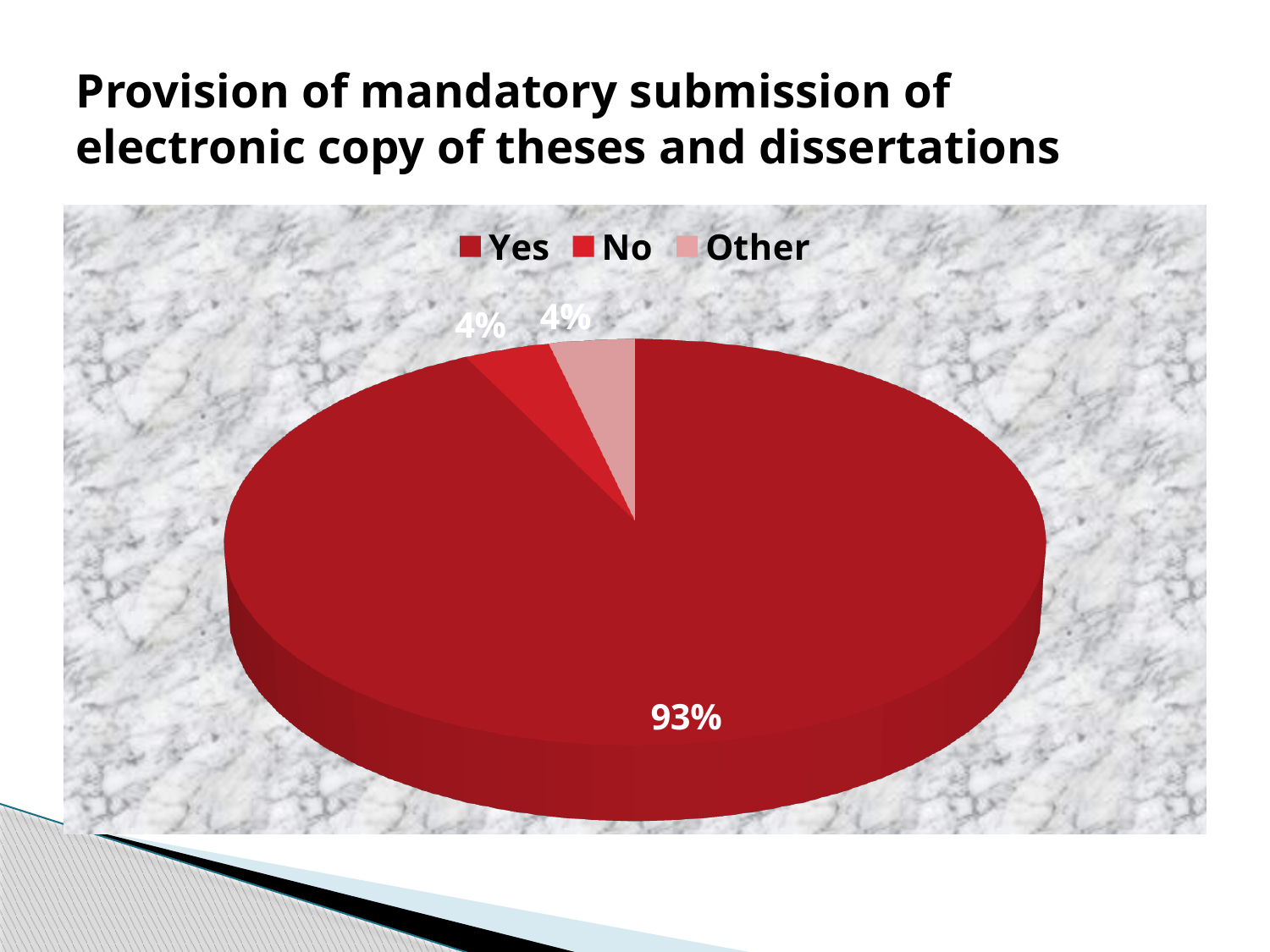
What is the title of the slide containing the pie chart? Provision of mandatory submission of electronic copy of theses and dissertations What share of the pie does the Yes slice represent? 93% Which category has the largest slice in the pie chart? Yes What percentage of the pie chart is labelled for the No slice? 4% Which legend entries are listed in the pie chart, in order from left to right? Yes, No, Other What kind of chart is shown on the slide? pie chart How many slices does the pie chart have? 3 What is the difference in percentage points between the Yes slice and the No slice? 89 What percentage of the pie chart is labelled for the Other slice? 4% Which slice is larger in the pie chart, Yes or No? Yes How many entries does the legend of the pie chart list? 3 What percentage of the pie chart is labelled for the Yes slice? 93%